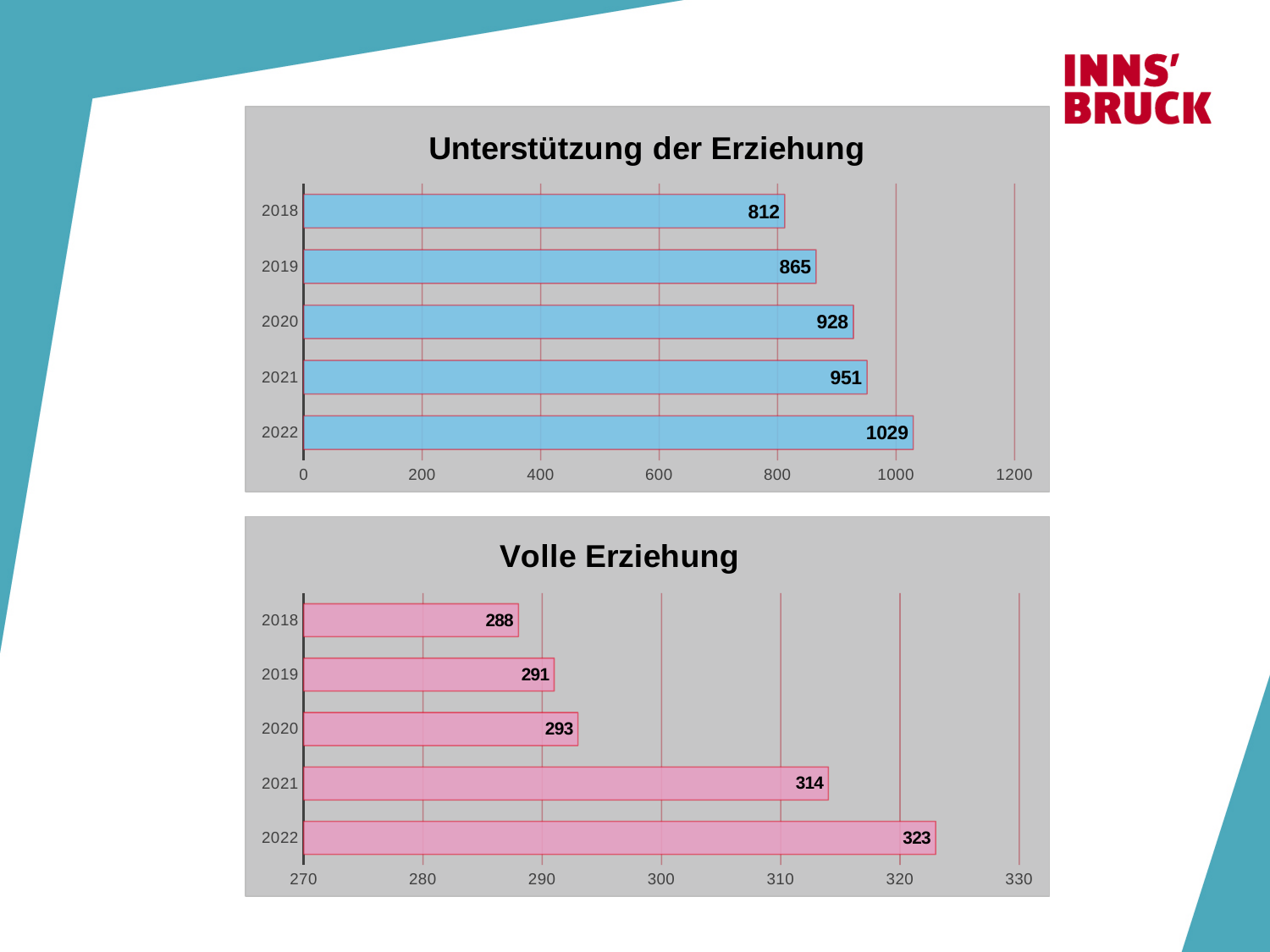
In the 'Volle Erziehung' chart, which year has the lowest value? 2018 In the 'Volle Erziehung' chart, what is the difference between the values for 2022 and 2021? 9 In the 'Volle Erziehung' chart, what is the value for 2021? 314 In the 'Volle Erziehung' chart, do the values rise or fall from 2018 to 2022? rise In the 'Unterstützung der Erziehung' chart, which year has the highest value? 2022 How many years are shown in the 'Volle Erziehung' chart? 5 In the 'Unterstützung der Erziehung' chart, which is larger, the value for 2019 or the value for 2021? 2021 What kind of chart is the 'Volle Erziehung' chart? bar chart In the 'Unterstützung der Erziehung' chart, what is the value for 2020? 928 In the 'Unterstützung der Erziehung' chart, what is the difference between the values for 2022 and 2018? 217 What is the title of the top chart on the slide? Unterstützung der Erziehung In the 'Unterstützung der Erziehung' chart, is the value for 2022 greater or less than 1000? greater